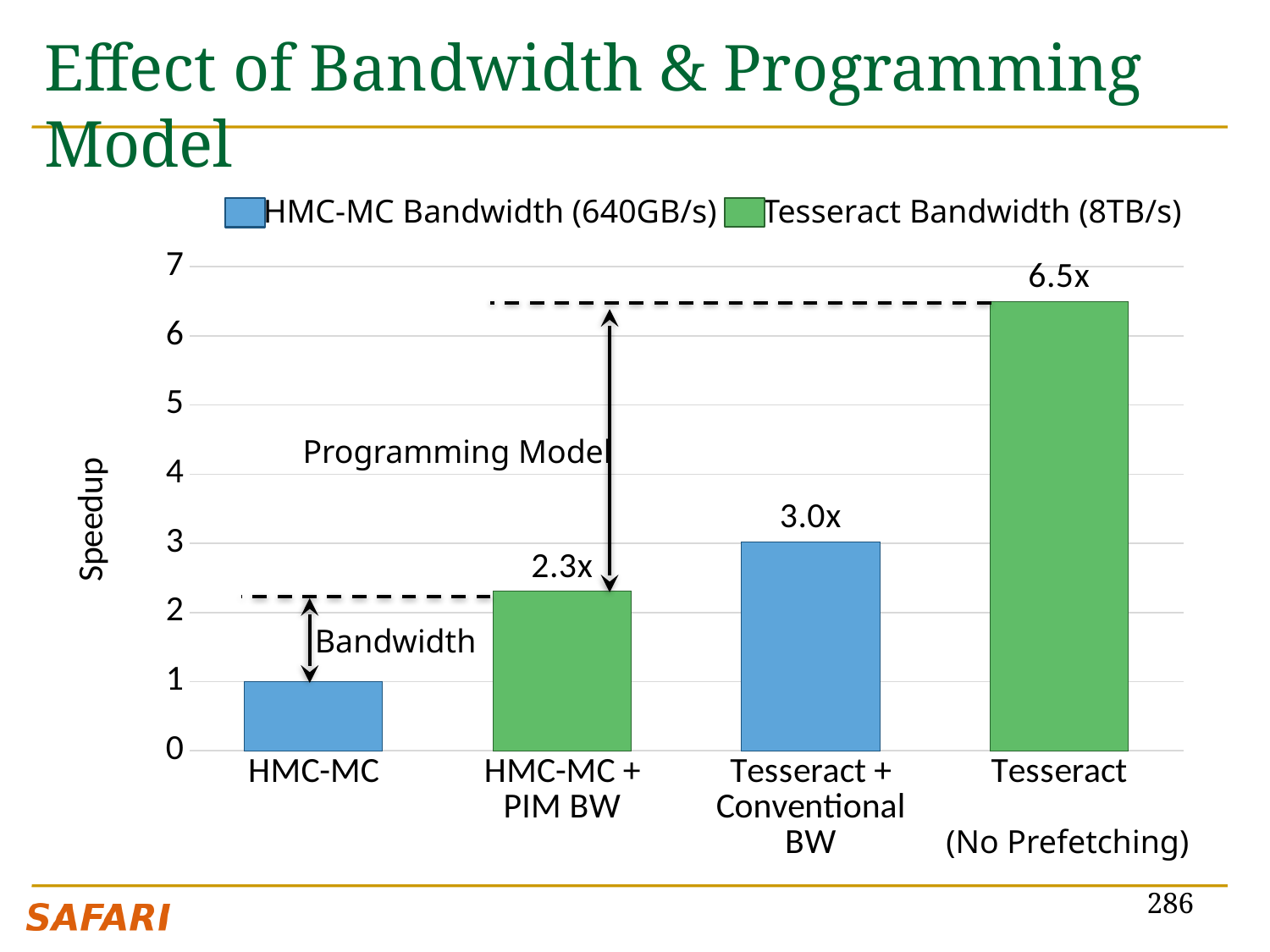
What is the speedup for HMC-MC + PIM BW? 2.3x Which configuration has the lowest speedup? HMC-MC How many configurations are shown on the x axis? 4 What is the difference in speedup between Tesseract (No Prefetching) and HMC-MC + PIM BW? 4.2x How many series does the legend list? 2 What is the speedup for Tesseract (No Prefetching)? 6.5x What kind of chart is shown on the slide? bar chart Which configuration has the highest speedup? Tesseract (No Prefetching) What is the difference in speedup between Tesseract + Conventional BW and HMC-MC + PIM BW? 0.7x Is the speedup for HMC-MC greater or less than 2? less What is the speedup for Tesseract + Conventional BW? 3.0x Which has a larger speedup, Tesseract + Conventional BW or HMC-MC + PIM BW? Tesseract + Conventional BW